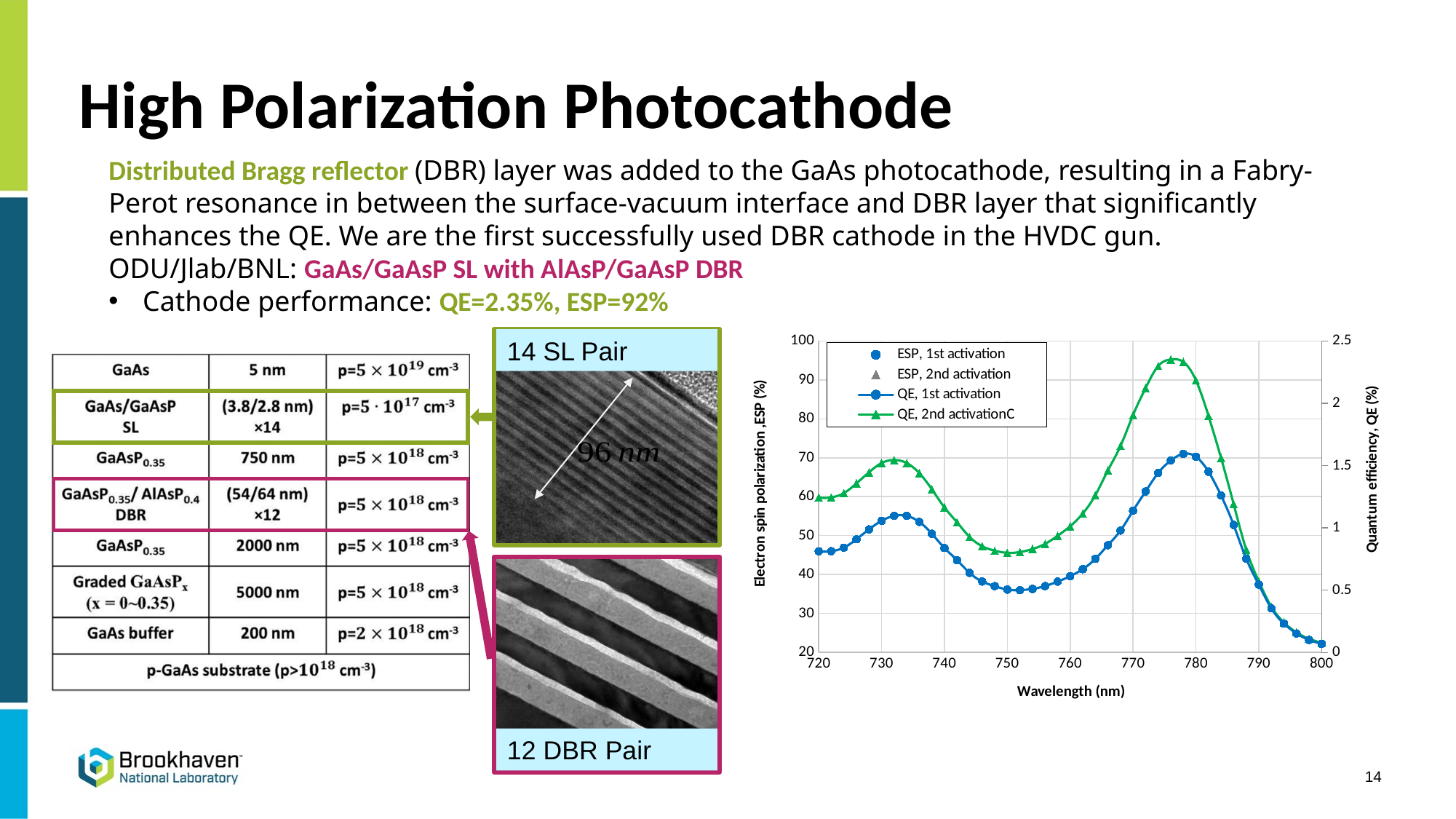
Is the peak value of the QE, 1st activation curve greater or less than 2 on the right-hand axis? less What kind of chart is shown on the right side of the slide? line chart Is the QE, 2nd activation value at 730 nm greater or less than 1 on the right-hand axis? greater What is the label of the right-hand y axis of the chart? Quantum efficiency, QE (%) What is the lowest wavelength tick shown on the x axis of the chart? 720 How many series does the legend of the chart list? 4 What is the label of the x axis of the chart? Wavelength (nm) Do the QE curves rise or fall as the wavelength increases from 780 nm to 800 nm? fall Which curve reaches a higher peak, QE, 1st activation or QE, 2nd activation? QE, 2nd activation Is the peak value of the QE, 2nd activation curve greater or less than 2 on the right-hand axis? greater What is the highest wavelength tick shown on the x axis of the chart? 800